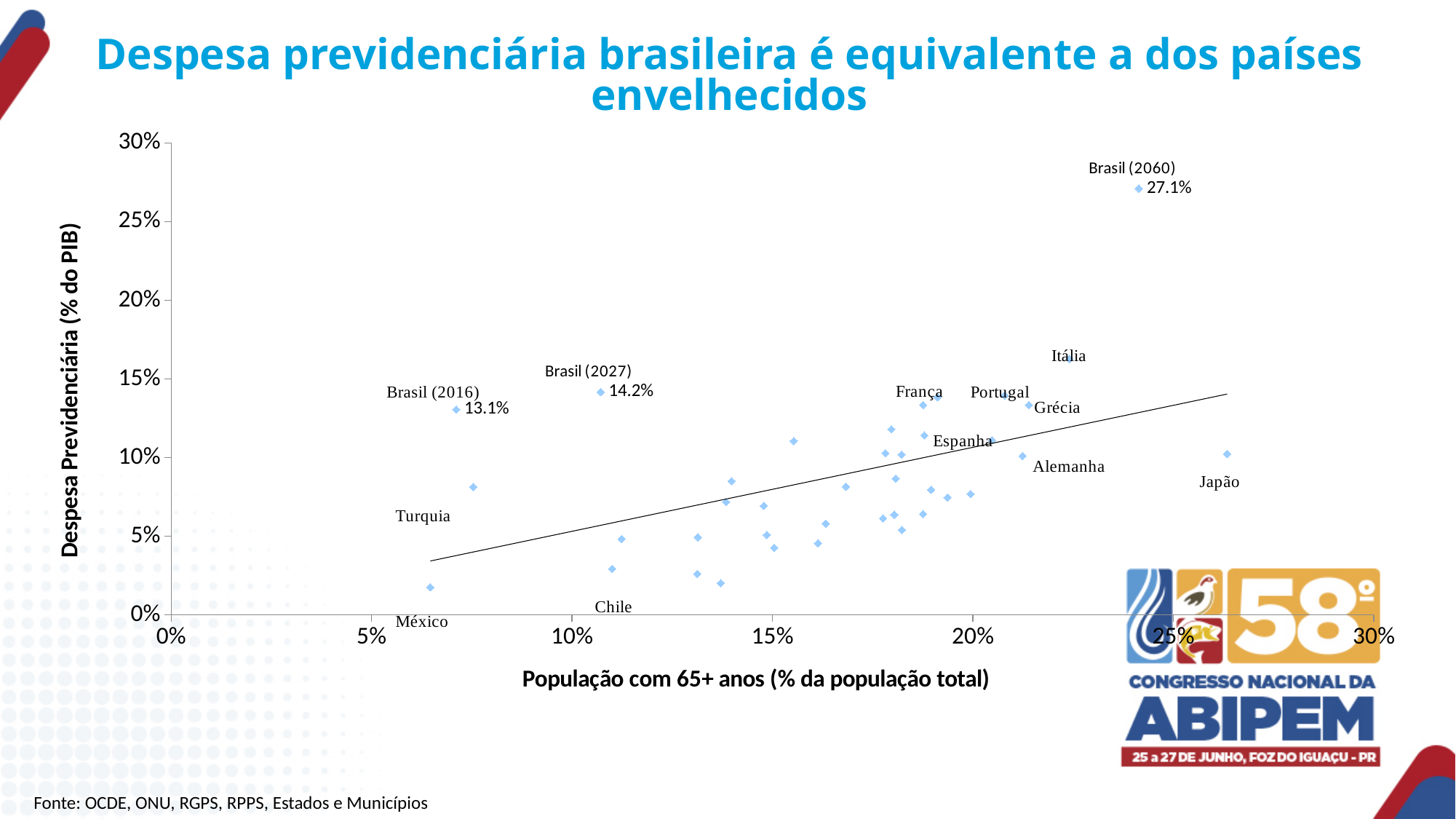
Which has the higher pension expenditure, Brasil (2027) or Brasil (2060)? Brasil (2060) Does the trend line in the chart rise or fall as the share of population aged 65+ increases? rise What is the title of the vertical axis of the chart? Despesa Previdenciária (% do PIB) What is the difference between the labelled values for Brasil (2027) and Brasil (2016)? 1.1 percentage points What is the pension expenditure value labelled for Brasil (2060)? 27.1% Is the pension expenditure value for México greater or less than 5%? less Is the pension expenditure value for Japão greater or less than 15%? less What is the pension expenditure value labelled for Brasil (2016)? 13.1% What is the difference between the labelled values for Brasil (2060) and Brasil (2016)? 14.0 percentage points What type of chart is shown on the slide? Scatter chart What is the pension expenditure value labelled for Brasil (2027)? 14.2% Which labelled point has the highest pension expenditure as % of GDP? Brasil (2060)